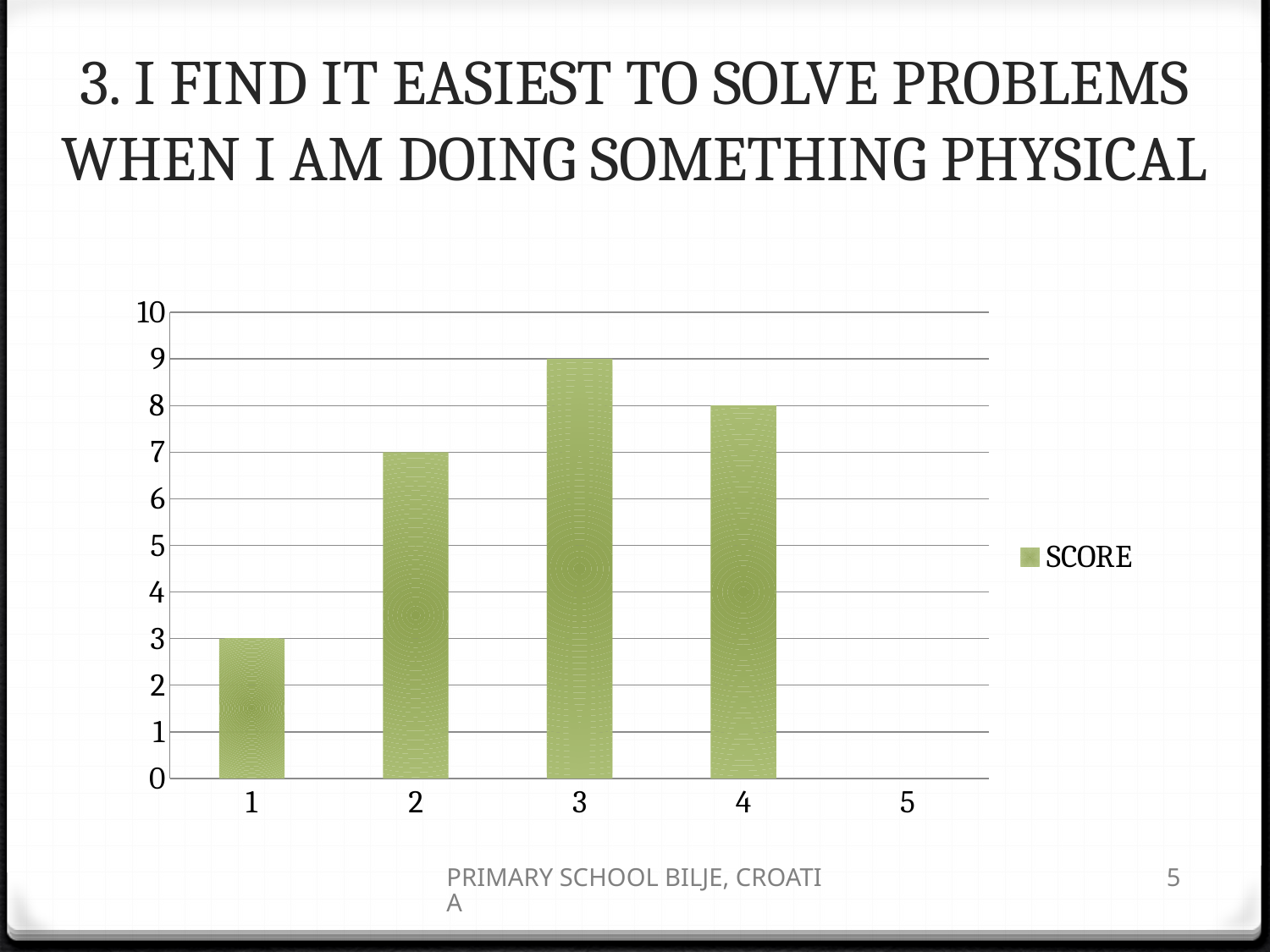
What is the SCORE value for category 4? 8 What is the SCORE value for category 1? 3 Is the SCORE for category 2 greater or less than 5? greater How many categories are shown on the x axis? 5 What is the difference between the SCORE for category 3 and category 1? 6 What is the SCORE value for category 2? 7 How many series does the legend list? 1 Which has a larger SCORE, category 2 or category 4? category 4 Which category has the highest SCORE? 3 What is the SCORE value for category 3? 9 Which category with a visible bar has the lowest SCORE? 1 What type of chart is shown on the slide? bar chart